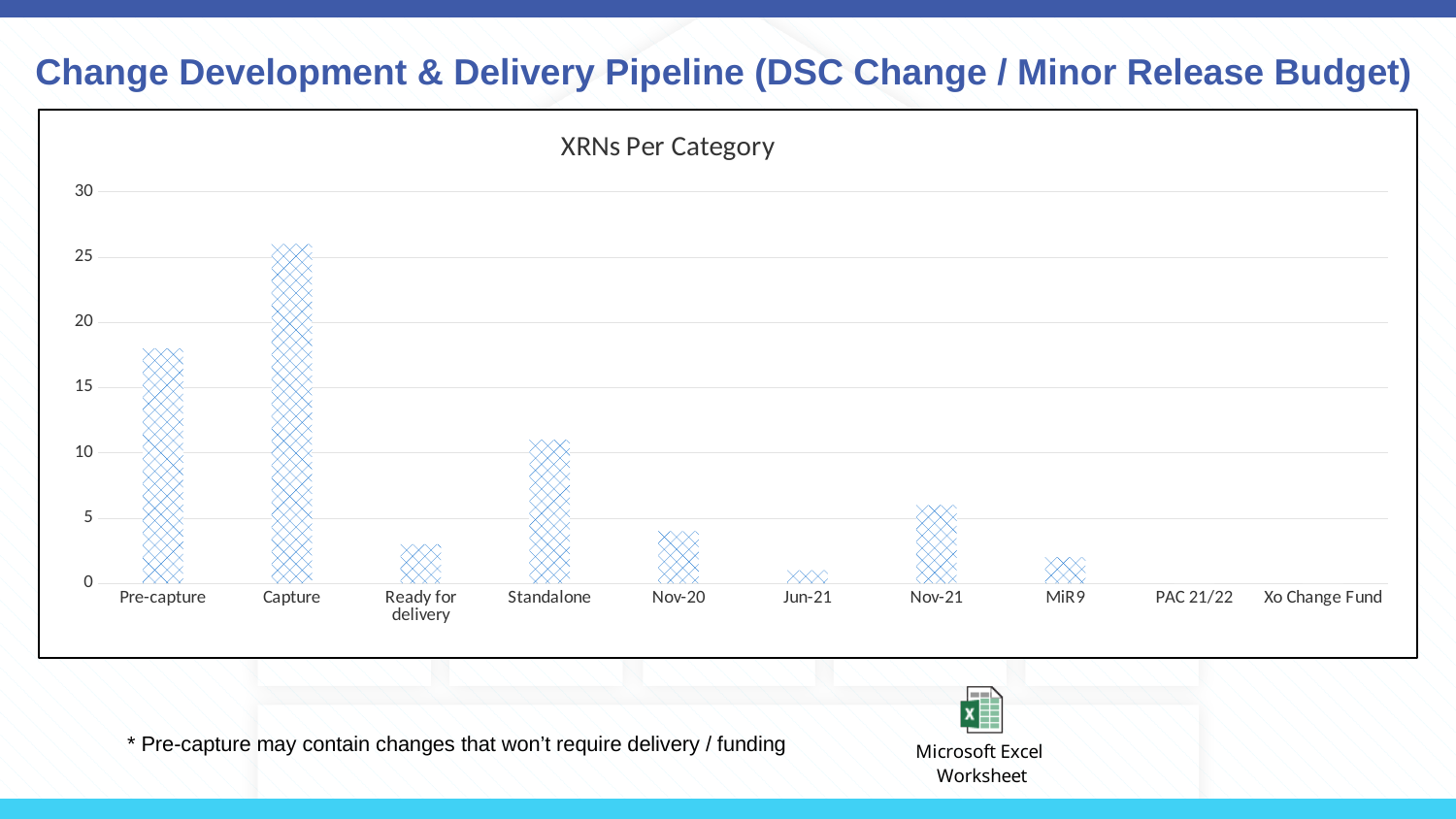
Is the value for Standalone greater or less than 10? greater What is the title of the chart? XRNs Per Category What kind of chart is shown on the slide? bar chart Which is larger, the value for Nov-20 or the value for Nov-21? Nov-21 Is the value for Capture greater or less than 20? greater Which is larger, the value for Pre-capture or the value for Standalone? Pre-capture Is the value for Pre-capture greater or less than 15? greater How many categories are shown on the x axis of the chart? 10 Which categories show no bar at all in the chart? PAC 21/22 and Xo Change Fund Which category has the highest value in the chart? Capture